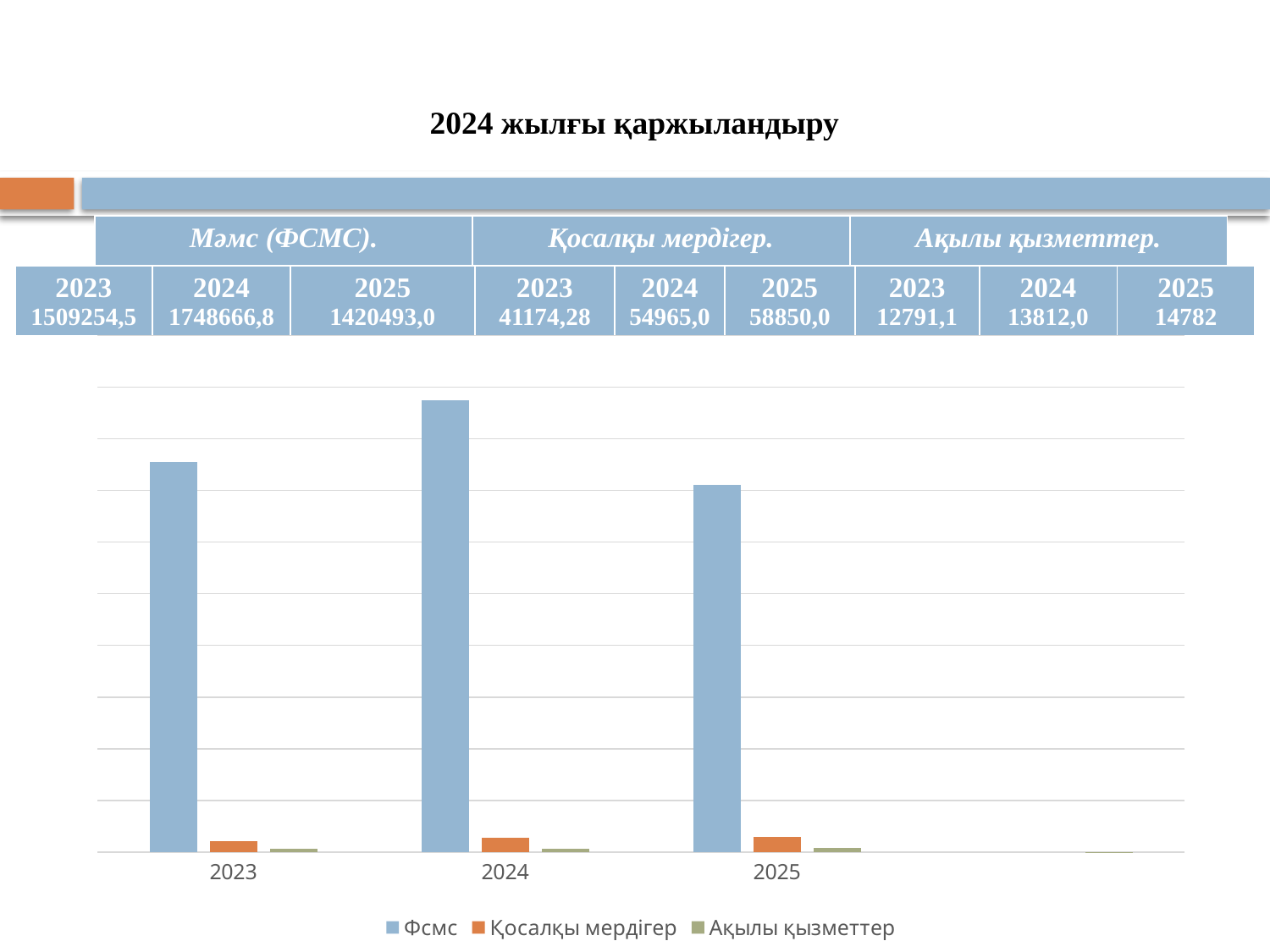
According to the table on the slide, what is the Мәмс (ФСМС) value for 2024? 1748666,8 How many series does the chart legend list? 3 Using the table values, what is the difference between the Қосалқы мердігер values for 2025 and 2024? 3885,0 In which year is the Фсмс bar the shortest? 2025 In which year is the Фсмс bar the tallest? 2024 Do the Қосалқы мердігер bars rise or fall from 2023 to 2025? rise How many years are shown along the x axis of the chart? 3 In 2025, which is larger, the Қосалқы мердігер bar or the Ақылы қызметтер bar? Қосалқы мердігер What is the title shown above the table and chart on the slide? 2024 жылғы қаржыландыру What kind of chart is shown on the slide? bar chart Which is larger, the Фсмс bar for 2023 or for 2025? 2023 According to the table on the slide, what is the Ақылы қызметтер value for 2025? 14782